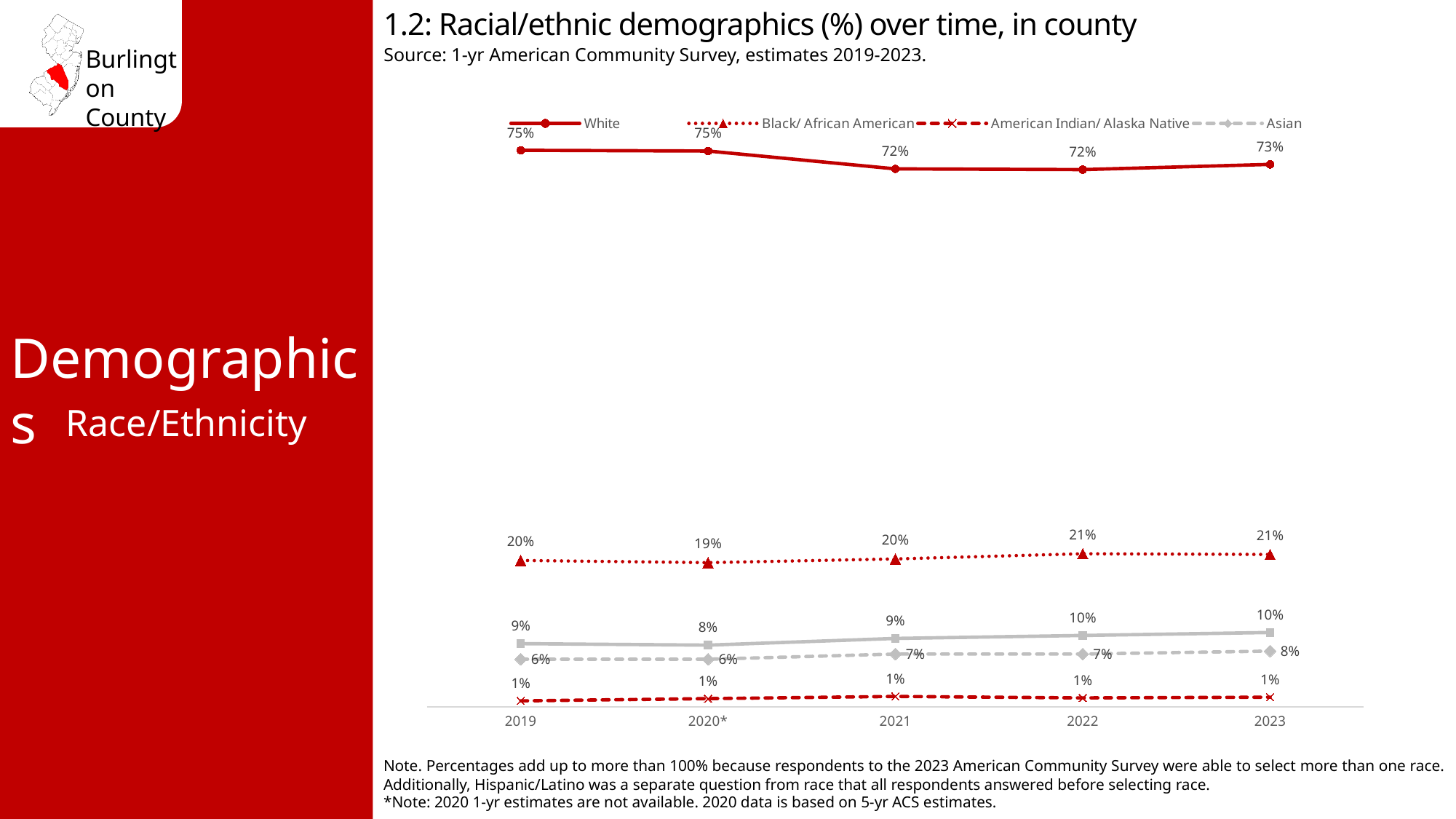
What is the value for White in 2021? 72% By how many percentage points did the White value change from 2019 to 2023? 2 percentage points What is the value for Asian in 2019? 6% In 2023, which is larger: the Asian value or the Black/ African American value? Black/ African American Which series has the lowest value in 2019? American Indian/ Alaska Native What kind of chart is shown on the slide? Line chart Which series has the highest value in 2023? White What is the difference between the Black/ African American value and the Asian value in 2023? 13 percentage points Does the Asian series rise or fall from 2019 to 2023? Rise What is the value for Black/ African American in 2023? 21% What is the value for American Indian/ Alaska Native in 2022? 1% How many years are shown on the x axis? 5